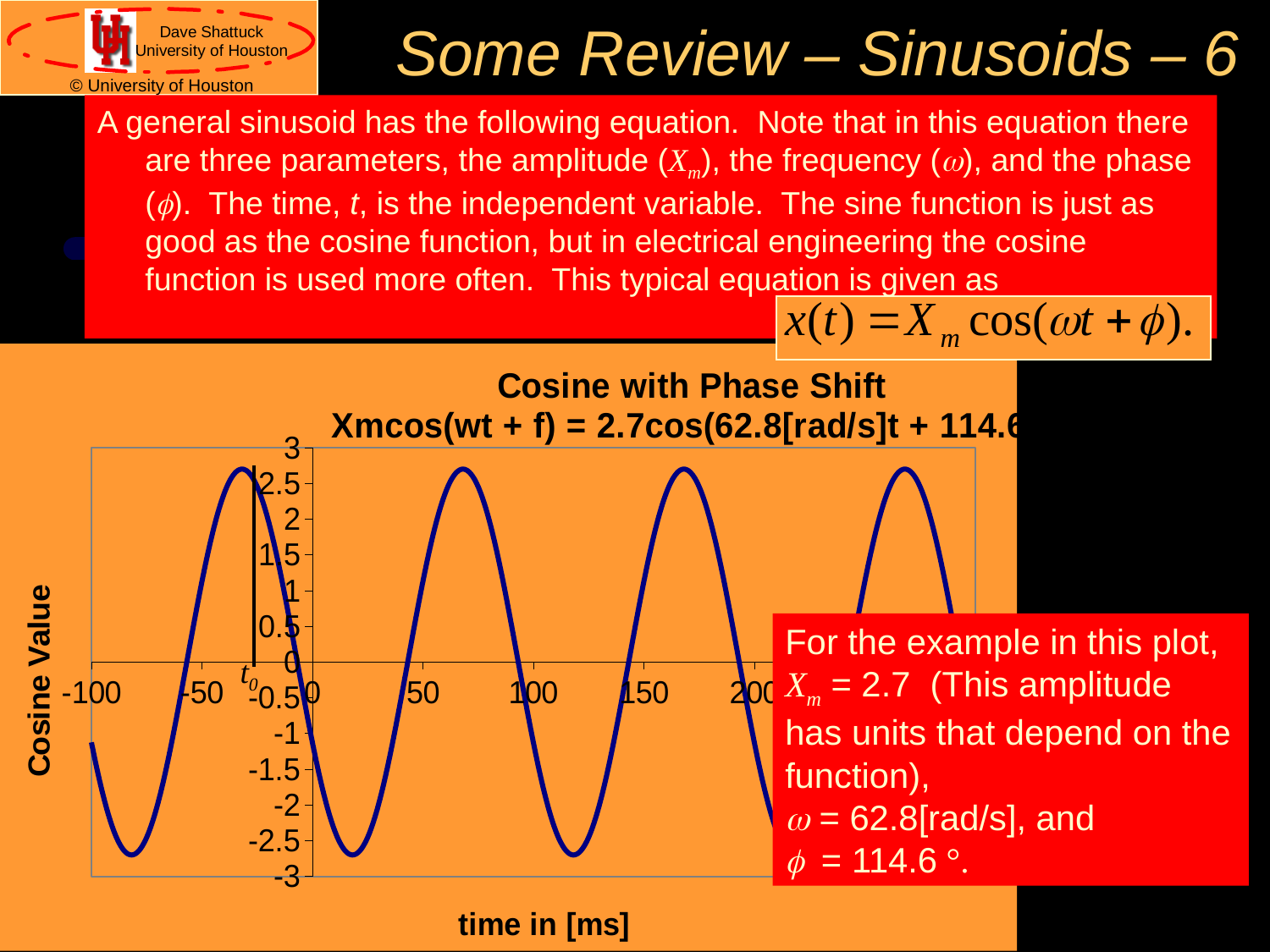
Is the peak value of the curve near -30 ms greater or less than 2? greater How many peaks (maxima) of the curve are visible on the chart? 3 Is the value of the curve at time 50 ms greater or less than 0? greater Is the minimum value of the curve near 20 ms greater or less than -2? less What kind of chart is shown on the slide? line chart Does the curve rise or fall between 0 ms and 20 ms? fall Does the curve rise or fall between 20 ms and 70 ms? rise What is the label on the vertical axis of the chart? Cosine Value What is the title of the chart (first line)? Cosine with Phase Shift